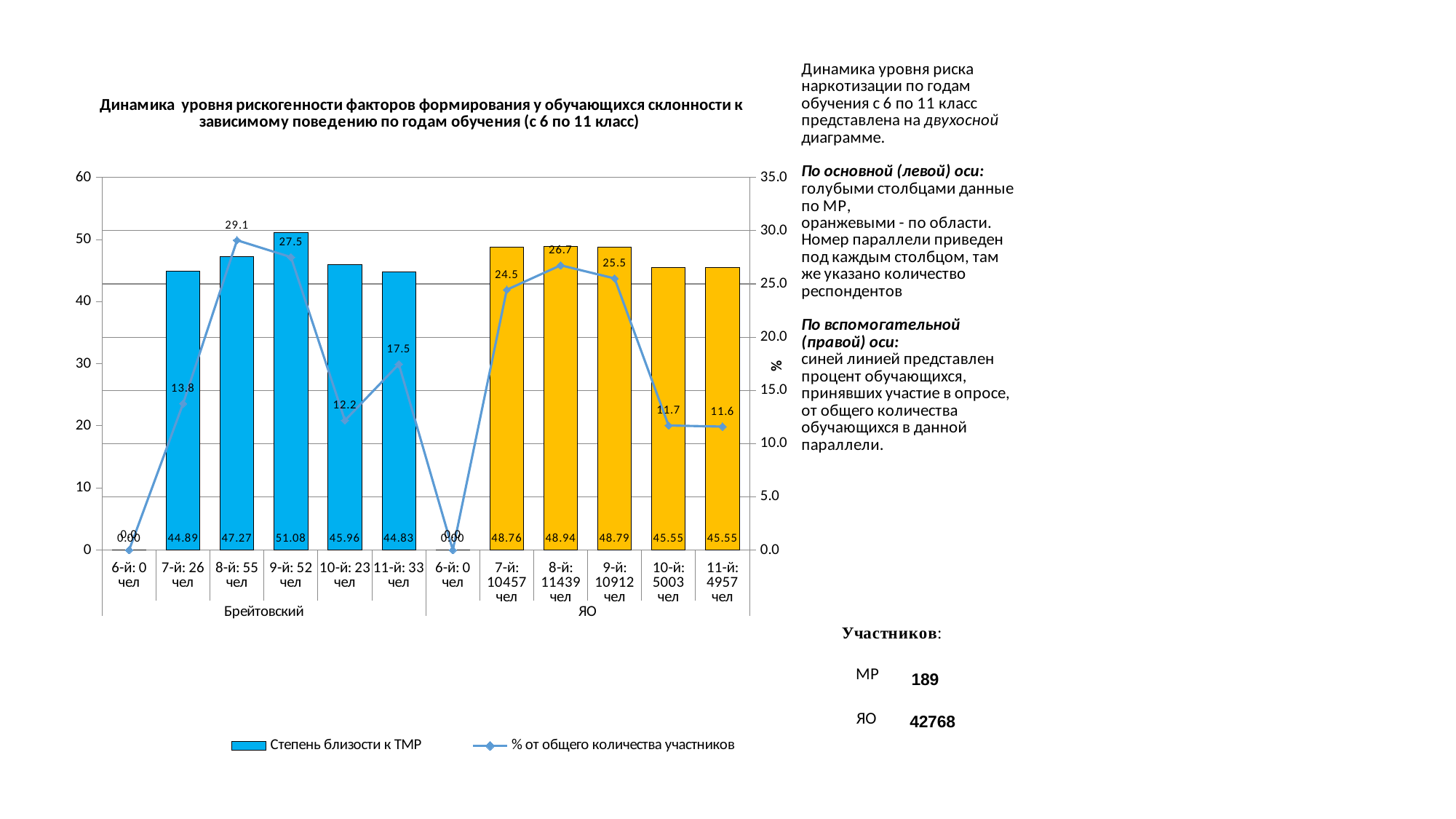
How many categories are shown along the x axis? 12 Which class in the ЯО group has the lowest non-zero '% от общего количества участников' value? 11-й Which class in the Брейтовский group has the highest 'Степень близости к ТМР' bar? 9-й What is the value of the 'Степень близости к ТМР' bar for the 9-й class in the Брейтовский group? 51.08 What kind of chart is this? Combined bar and line chart What is the '% от общего количества участников' value for the 11-й class in the ЯО group? 11.6 What is the difference between the 'Степень близости к ТМР' values for the 9-й class in Брейтовский (51.08) and the 7-й class in Брейтовский (44.89)? 6.19 What is the label of the secondary (right) axis? % What is the '% от общего количества участников' value for the 8-й class in the Брейтовский group? 29.1 How many series does the legend list? 2 Which is larger: the 'Степень близости к ТМР' bar for the 10-й class in Брейтовский or for the 10-й class in ЯО? 10-й class in Брейтовский (45.96) What is the value of the 'Степень близости к ТМР' bar for the 8-й class in the ЯО group? 48.94